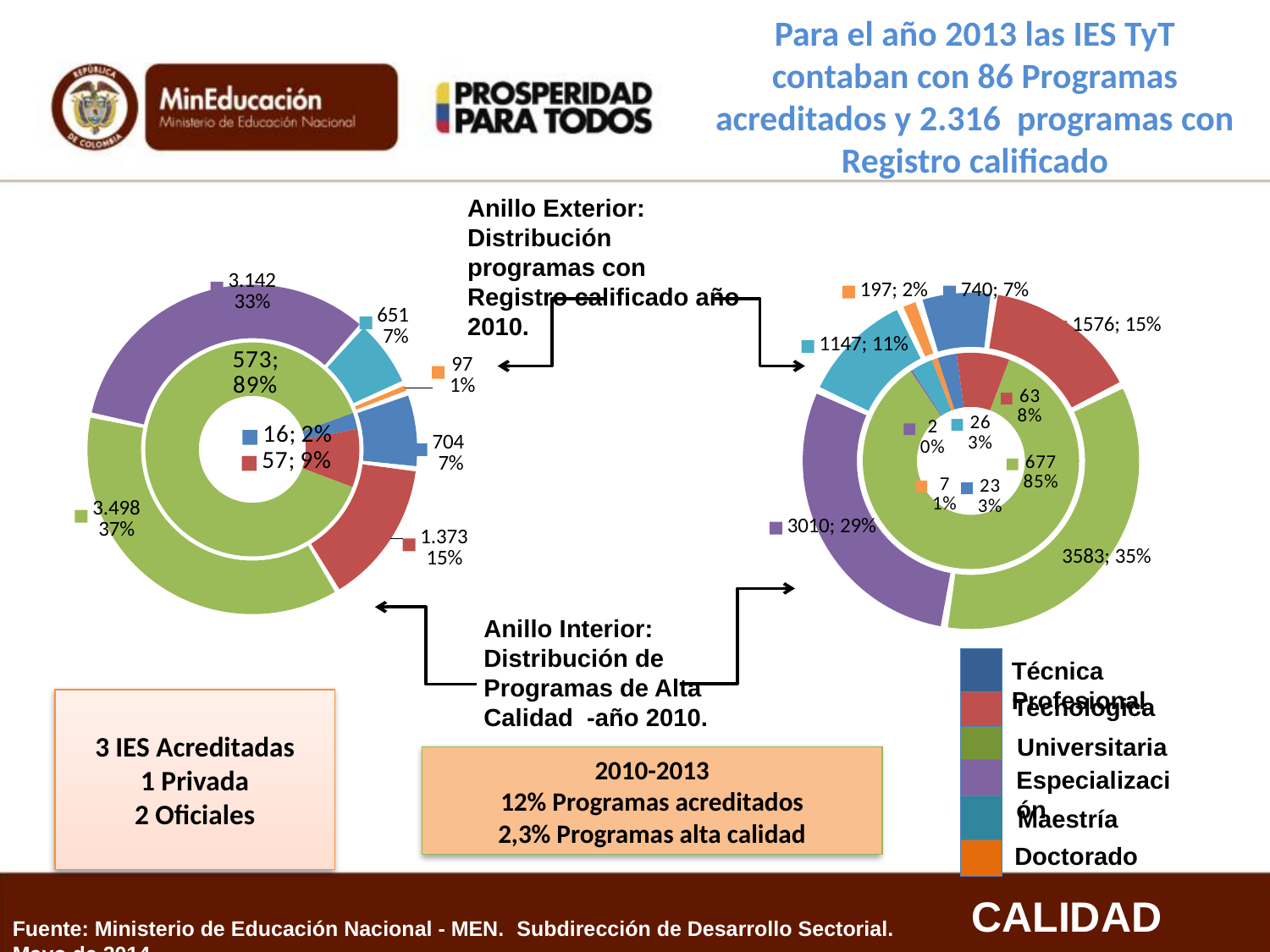
In the right chart, what value and percentage are shown for the purple outer-ring segment (Especialización)? 3010; 29% In the right chart, what is the difference between the outer-ring values for Universitaria (3583) and Especialización (3010)? 573 In the left chart, what value is shown for the orange outer-ring segment (Doctorado)? 97 In the right chart, what value is shown for the green inner-ring segment? 677 In the right chart, which outer-ring segment is the largest? Universitaria (3583; 35%) In the left chart, what value and percentage are shown for the largest outer-ring segment (green, Universitaria)? 3.498, 37% In the left chart, what value and percentage are shown for the green inner-ring segment? 573; 89% In the right chart, which outer-ring value is larger: Maestría (1147) or Tecnológica (1576)? Tecnológica (1576) How many entries does the legend on the slide list? 6 What kind of chart is the left chart on the slide? doughnut chart In the left chart, which outer-ring segment is the smallest? Doctorado (97, 1%) In the right chart, what value and percentage are shown for the green outer-ring segment (Universitaria)? 3583; 35%